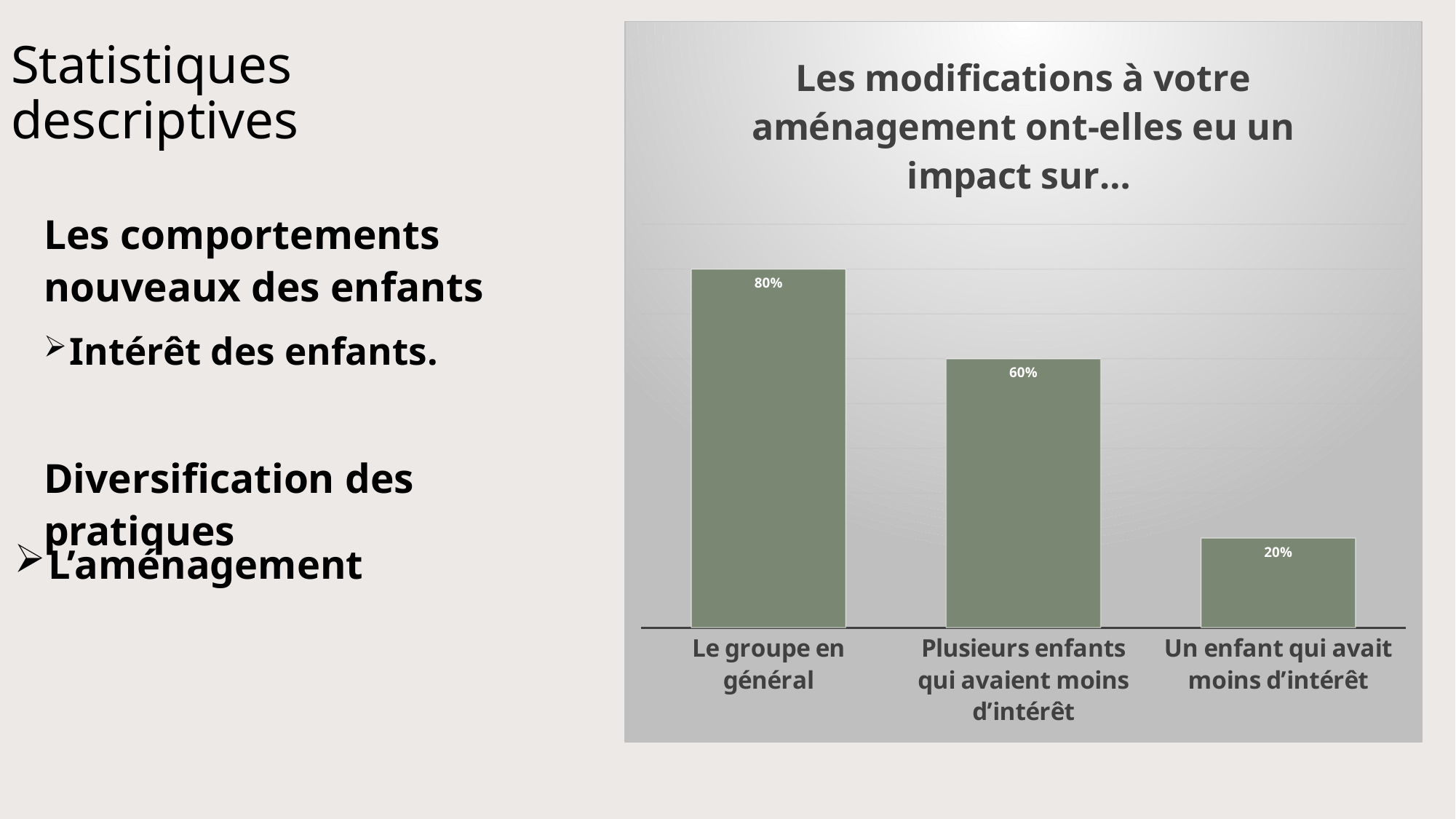
What is the value for "Un enfant qui avait moins d'intérêt"? 20% What is the value for "Le groupe en général"? 80% What is the title of the chart? Les modifications à votre aménagement ont-elles eu un impact sur… What is the value for "Plusieurs enfants qui avaient moins d'intérêt"? 60% What kind of chart is shown on the slide? Bar chart Which category has the highest value? Le groupe en général What is the difference between the values for "Le groupe en général" and "Plusieurs enfants qui avaient moins d'intérêt"? 20% Which is larger: the value for "Plusieurs enfants qui avaient moins d'intérêt" or for "Un enfant qui avait moins d'intérêt"? Plusieurs enfants qui avaient moins d'intérêt Which category has the lowest value? Un enfant qui avait moins d'intérêt What is the difference between the values for "Le groupe en général" and "Un enfant qui avait moins d'intérêt"? 60% Do the values rise or fall from left to right across the categories? Fall How many categories are shown in the chart? 3